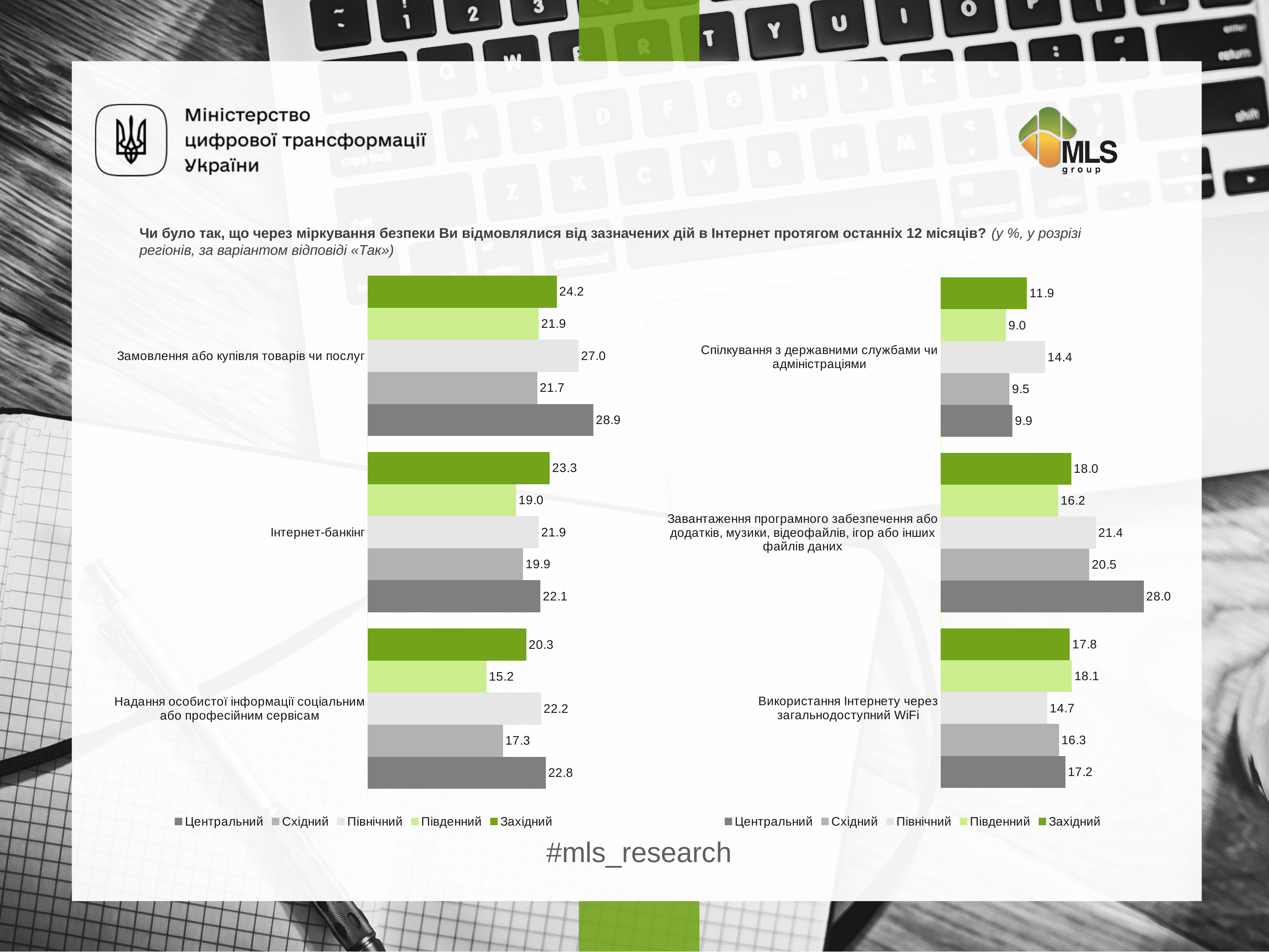
In the right chart, which is larger for Використання Інтернету через загальнодоступний WiFi: Західний or Північний? Західний In the left chart, what is the difference between the Центральний and Східний values for Замовлення або купівля товарів чи послуг? 7.2 In the right chart, what is the difference between the Центральний and Південний values for Завантаження програмного забезпечення або додатків, музики, відеофайлів, ігор або інших файлів даних? 11.8 In the right chart, what is the value for Північний for Спілкування з державними службами чи адміністраціями? 14.4 In the right chart, which region has the lowest value for Спілкування з державними службами чи адміністраціями? Південний In the right chart, what is the value for Центральний for Завантаження програмного забезпечення або додатків, музики, відеофайлів, ігор або інших файлів даних? 28.0 In the left chart, which region has the highest value for Надання особистої інформації соціальним або професійним сервісам? Центральний What kind of chart is the left chart? Bar chart How many categories are shown in the right chart? 3 In the left chart, what is the value for Центральний for Замовлення або купівля товарів чи послуг? 28.9 How many series does the legend of the left chart list? 5 In the left chart, what is the value for Південний for Інтернет-банкінг? 19.0